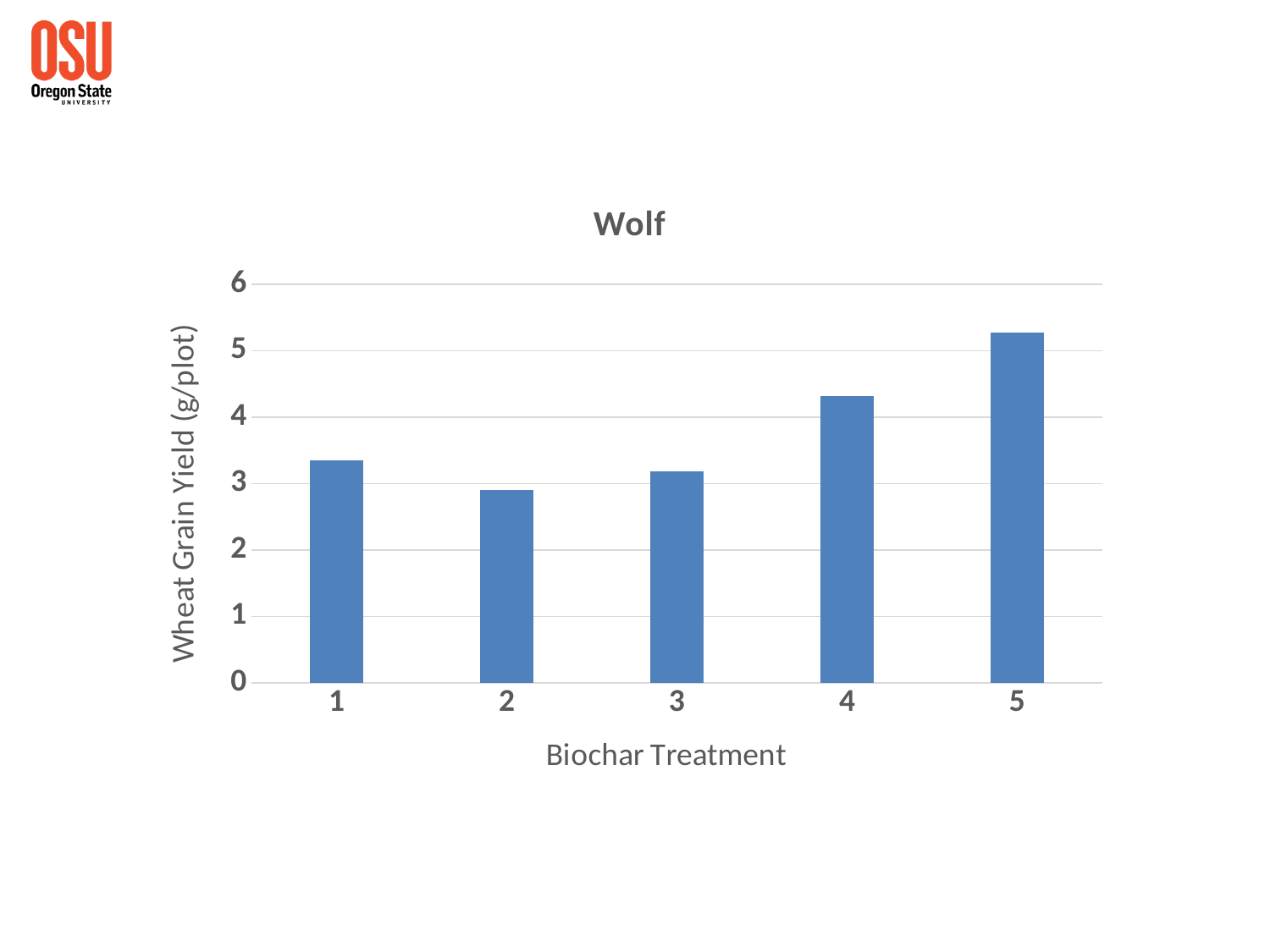
What kind of chart is shown on the slide? bar chart Is the wheat grain yield for biochar treatment 4 greater or less than 4? greater Which biochar treatment has the lowest wheat grain yield? 2 Is the wheat grain yield for biochar treatment 2 greater or less than 3? less What is the label of the y axis? Wheat Grain Yield (g/plot) Is the wheat grain yield for biochar treatment 3 greater or less than 4? less How many biochar treatments are plotted on the chart? 5 Which has a higher wheat grain yield, biochar treatment 4 or biochar treatment 5? 5 What is the title of the chart? Wolf Which biochar treatment has the highest wheat grain yield? 5 Which has a higher wheat grain yield, biochar treatment 1 or biochar treatment 2? 1